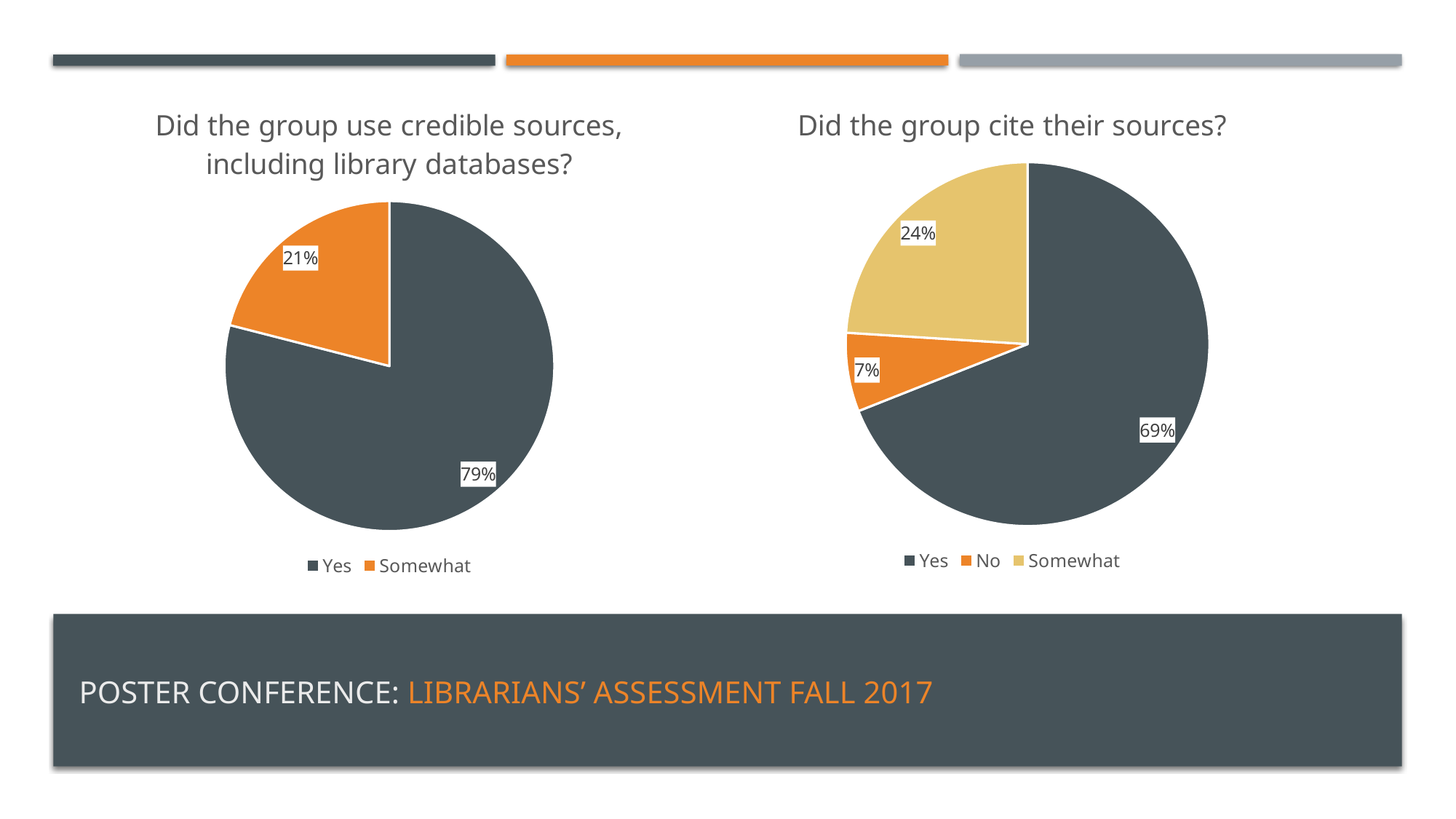
In the chart titled "Did the group cite their sources?", which category has the largest slice? Yes What kind of chart is the chart on the left of the slide? Pie chart In the chart titled "Did the group use credible sources, including library databases?", what is the difference between the "Yes" and "Somewhat" values? 58% In the chart titled "Did the group cite their sources?", which is larger, "Somewhat" or "No"? Somewhat In the chart titled "Did the group cite their sources?", what is the difference between the "Yes" and "Somewhat" values? 45% In the chart titled "Did the group cite their sources?", what share of the pie is "Somewhat"? 24% In the chart titled "Did the group cite their sources?", which category has the smallest slice? No In the chart titled "Did the group use credible sources, including library databases?", what share of the pie is "Yes"? 79% In the chart titled "Did the group cite their sources?", what is the value for "No"? 7% How many categories does the legend list in the chart titled "Did the group use credible sources, including library databases?"? 2 In the chart titled "Did the group use credible sources, including library databases?", what is the value for "Somewhat"? 21% How many categories does the legend list in the chart titled "Did the group cite their sources?"? 3